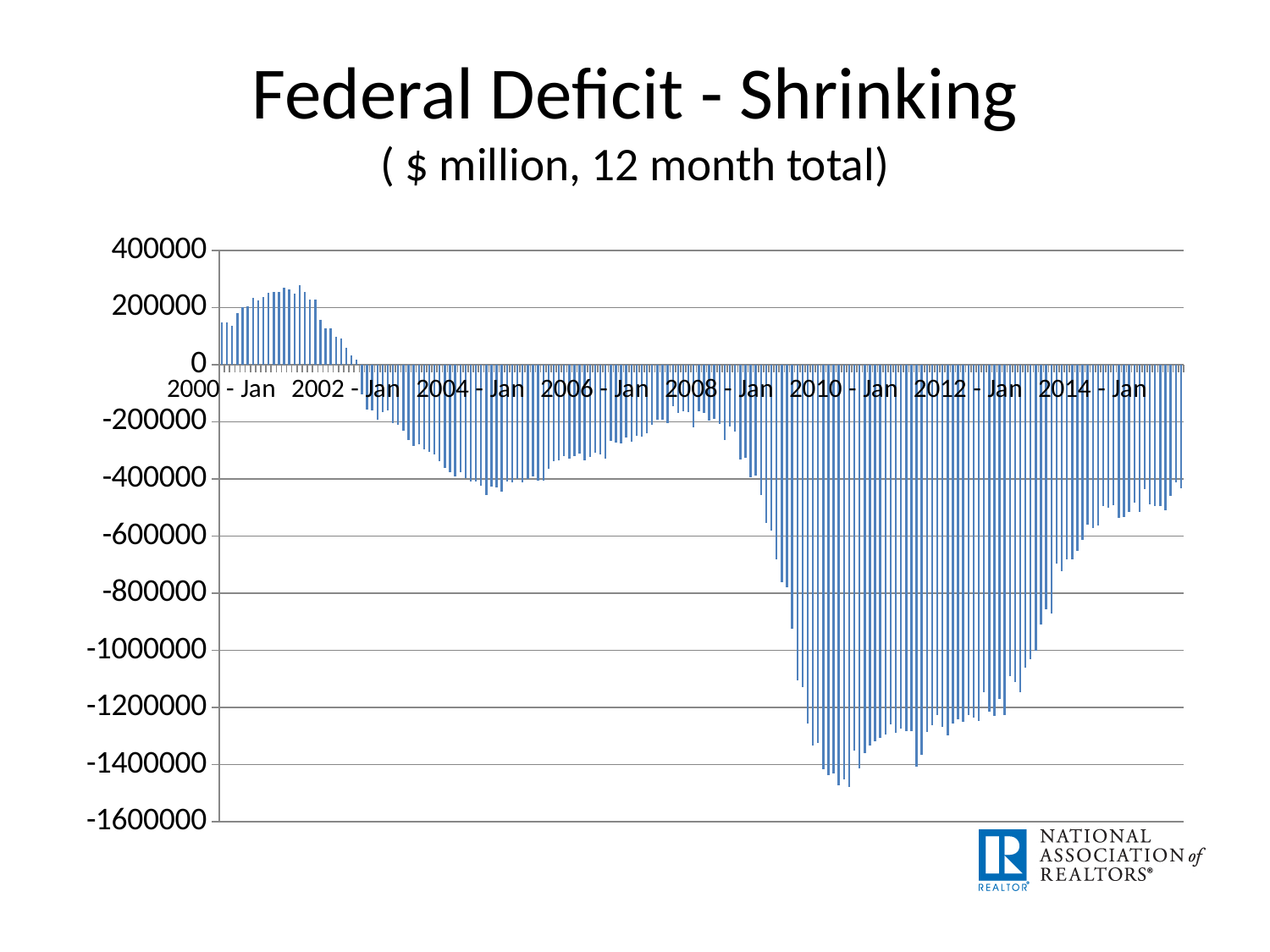
What units does the chart subtitle say the values are in? $ million, 12 month total Is the value for 2012 - Jan greater or less than -1000000? less What kind of chart is shown on the slide? bar chart Is the value for 2010 - Jan greater or less than -1200000? less Is the value for 2014 - Jan greater or less than -800000? greater Do the values rise or fall between 2008 - Jan and 2010 - Jan? fall What is the title of the chart? Federal Deficit - Shrinking Do the values rise or fall between 2010 - Jan and 2014 - Jan? rise